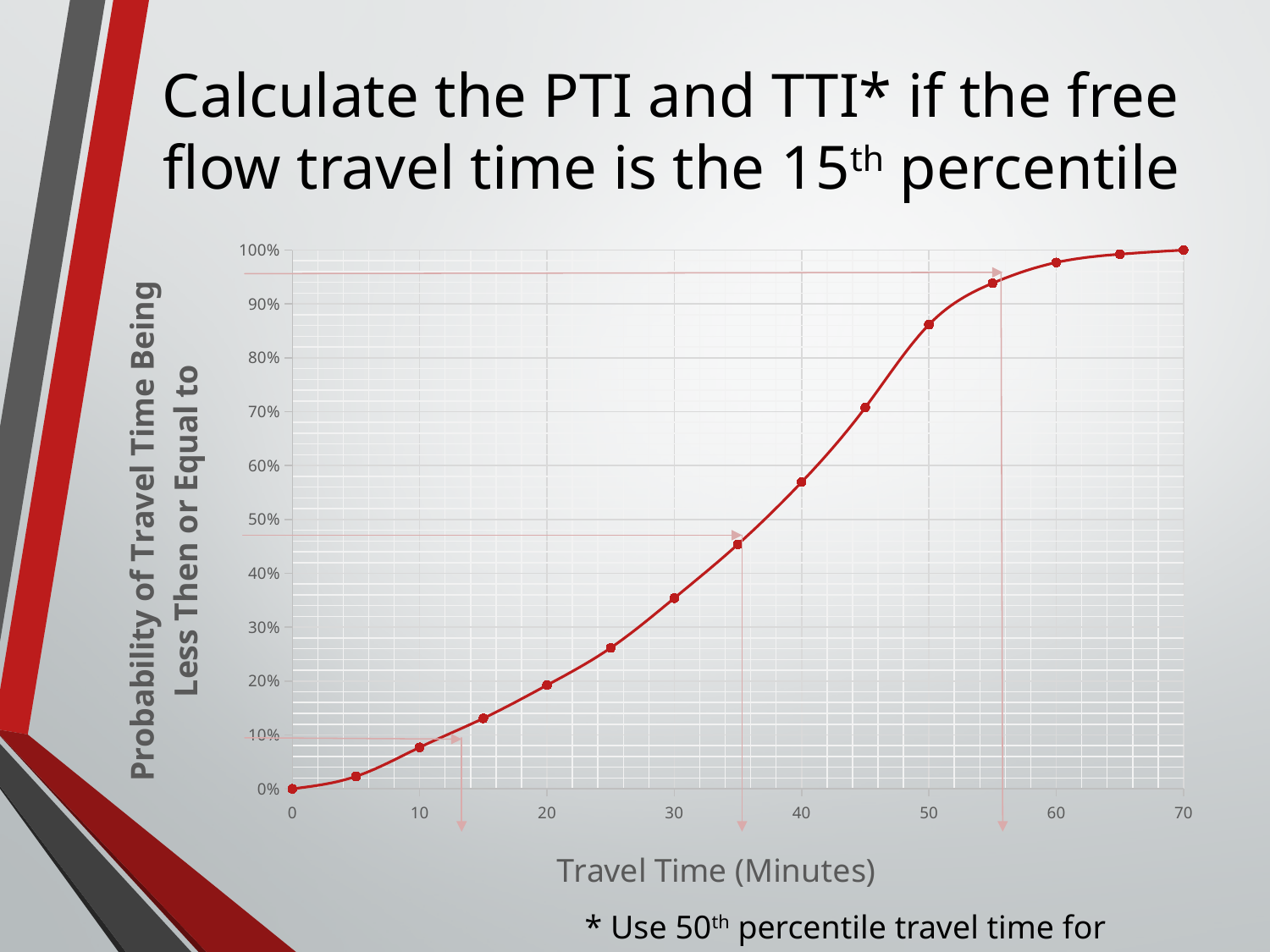
How many data points are plotted on the curve? 15 What is the probability value plotted at a travel time of 0 minutes? 0% Is the value at a travel time of 40 minutes greater or less than 50%? greater Is the value at a travel time of 30 minutes greater or less than 40%? less Is the value at a travel time of 50 minutes greater or less than 80%? greater Do the plotted values rise or fall as travel time increases along the x axis? rise What is the probability value plotted at a travel time of 70 minutes? 100% Which is larger, the value at 40 minutes or the value at 30 minutes? 40 minutes What is the title of the x axis? Travel Time (Minutes) What kind of chart is shown on the slide? line chart Which travel time has the highest plotted probability? 70